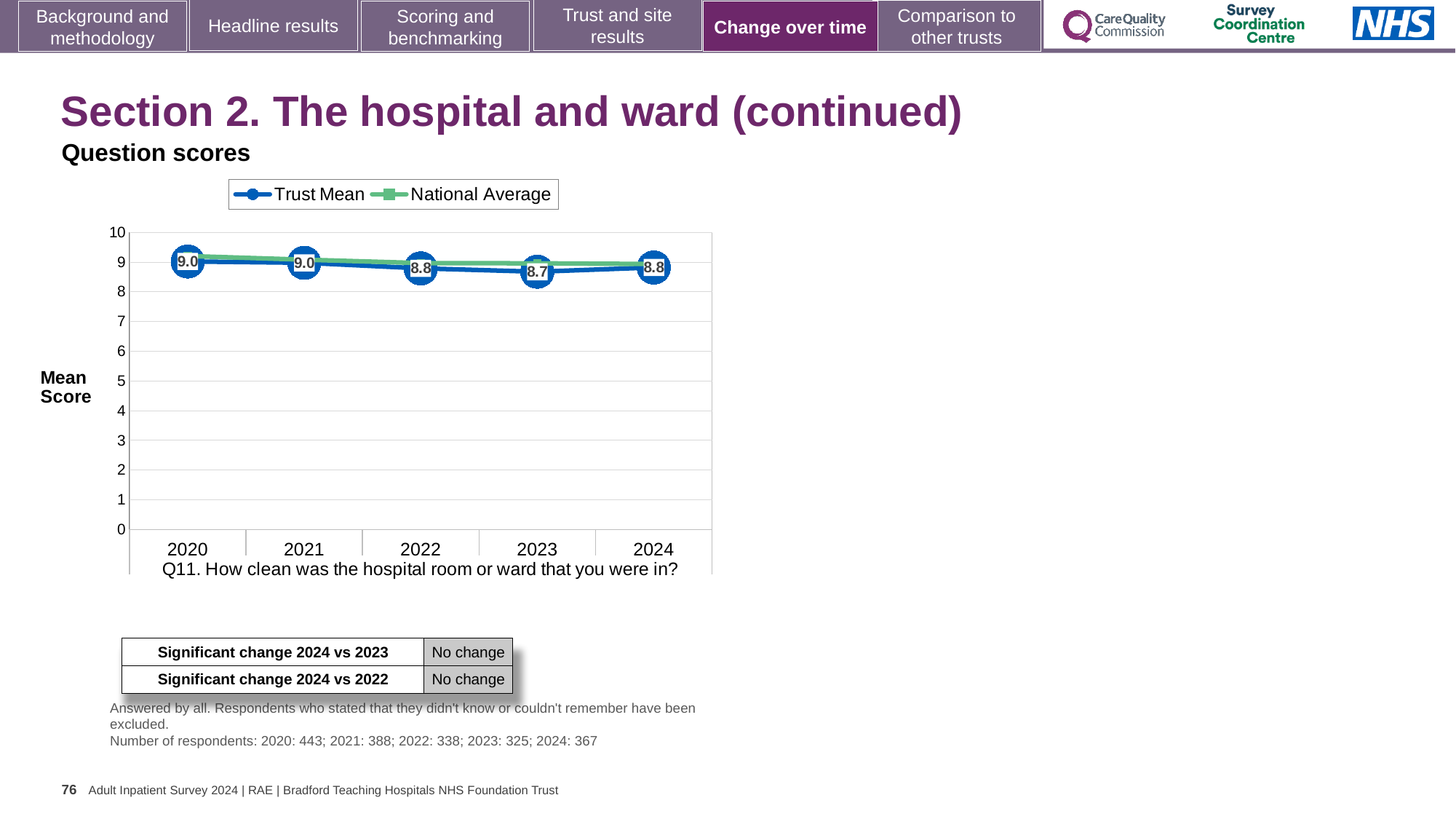
What is the Trust Mean value for 2022? 8.8 In which year is the Trust Mean lowest? 2023 Does the Trust Mean rise or fall from 2020 to 2023? fall What is the Trust Mean value for 2024? 8.8 What is the Trust Mean value for 2023? 8.7 Is the National Average value for 2024 greater or less than 8? greater What is the Trust Mean value for 2020? 9.0 Which year has the larger Trust Mean, 2021 or 2023? 2021 How many series does the chart legend list? 2 What kind of chart is shown on the slide? line chart How many years are shown on the x axis of the chart? 5 What is the difference between the Trust Mean in 2020 and in 2023? 0.3